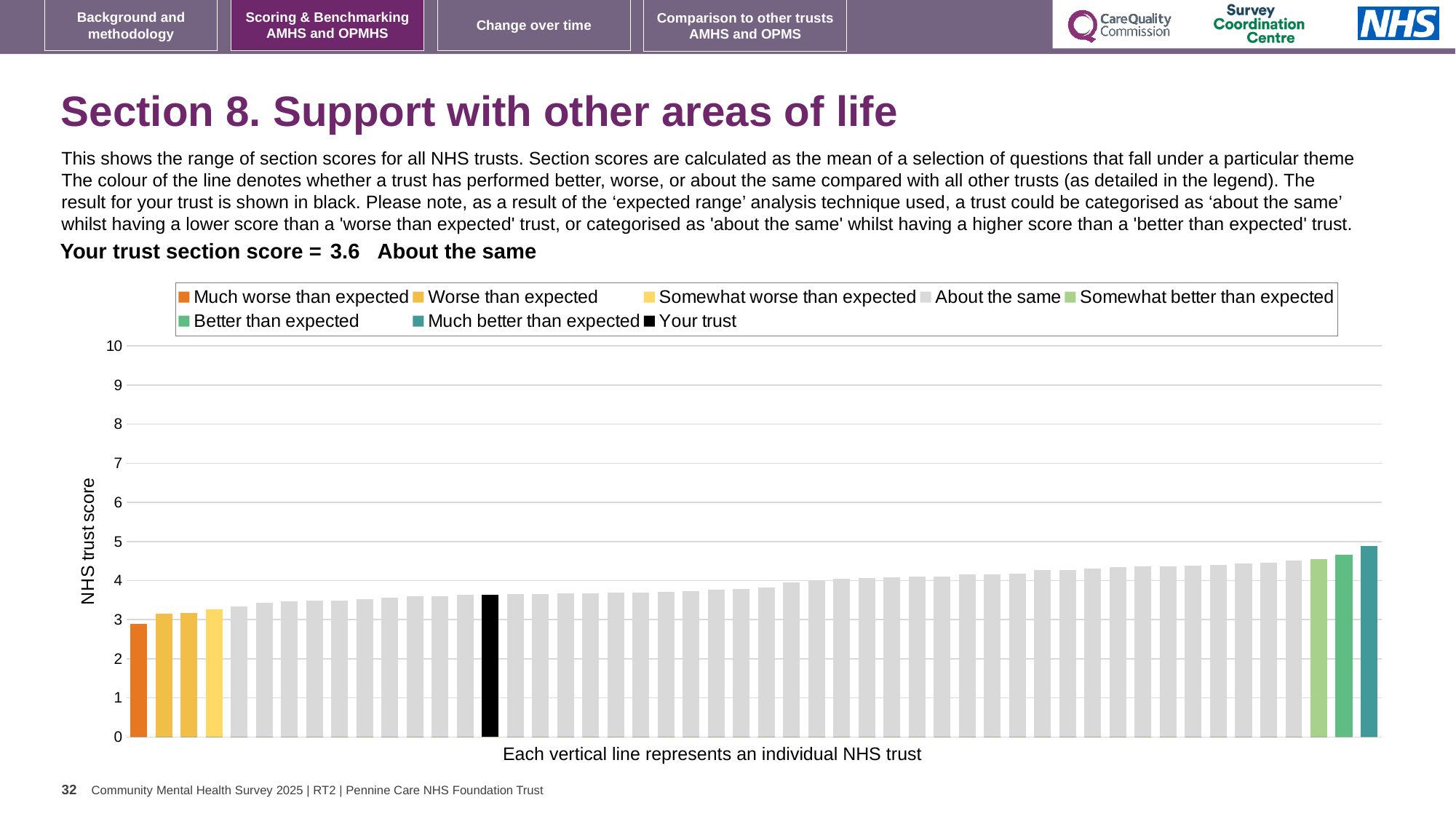
What is the section score for your trust? 3.6 Is the value for your trust greater or less than 4? less What is the label on the vertical axis of the chart? NHS trust score How many bars are coloured as 'Worse than expected'? 2 Which category is your trust's section score placed in? About the same Is the value of the tallest bar greater or less than 4? greater Which legend category does the shortest bar belong to? Much worse than expected Do the bar values rise or fall from left to right along the x axis? rise How many entries does the chart legend list? 8 What kind of chart is shown on the slide? bar chart Which legend category does the tallest bar belong to? Much better than expected Is the value for your trust greater or less than 3? greater